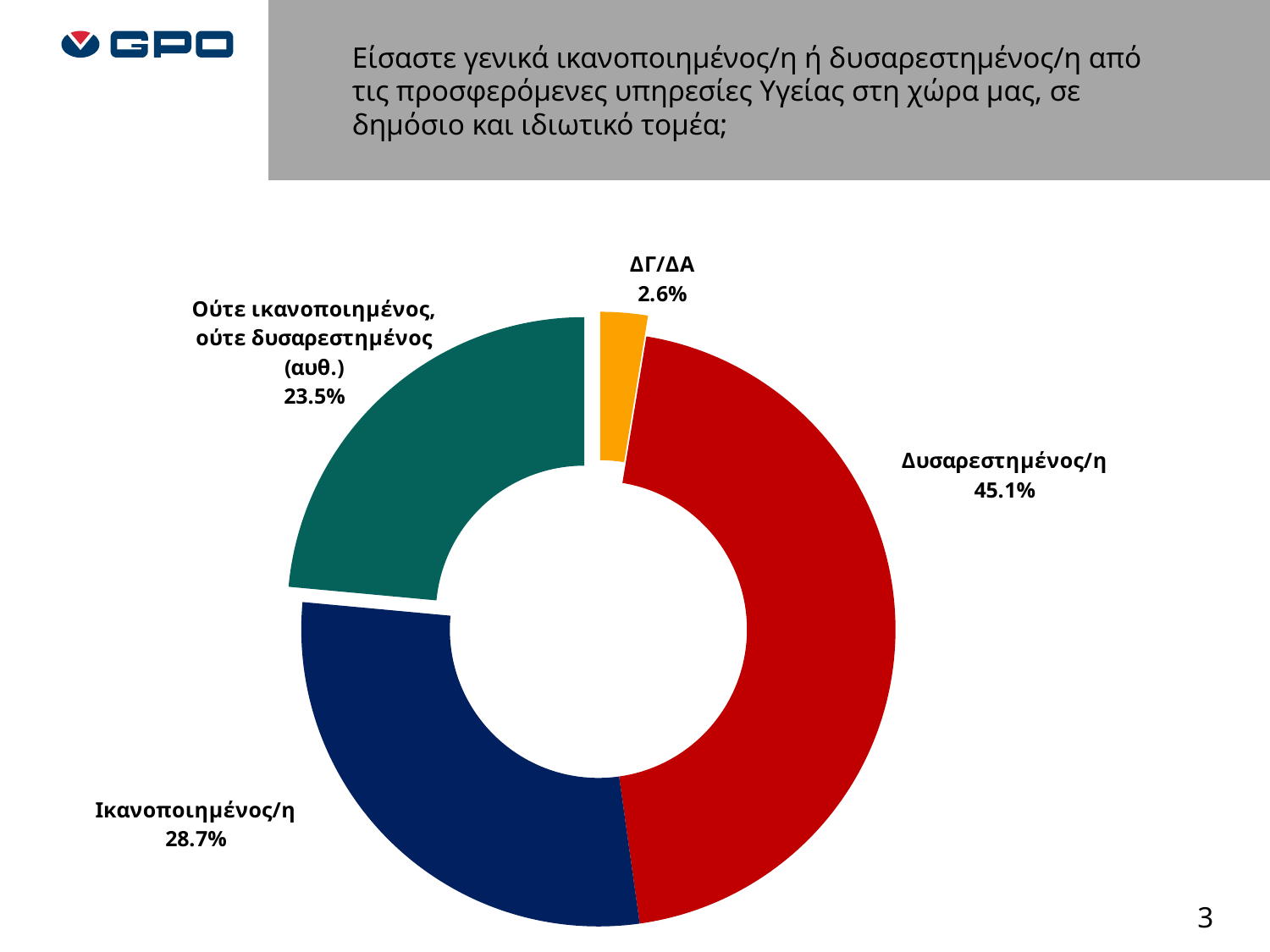
What is the difference in percentage points between Δυσαρεστημένος/η and Ικανοποιημένος/η? 16.4 percentage points Which is larger: the share for Ικανοποιημένος/η or the share for Ούτε ικανοποιημένος, ούτε δυσαρεστημένος (αυθ.)? Ικανοποιημένος/η What percentage of respondents answered Δυσαρεστημένος/η? 45.1% Which category has the largest share of the chart? Δυσαρεστημένος/η Which category has the smallest share of the chart? ΔΓ/ΔΑ What colour is the slice for Δυσαρεστημένος/η? Red What colour is the slice for ΔΓ/ΔΑ? Orange How many categories are shown in the chart? 4 What percentage of respondents answered Ούτε ικανοποιημένος, ούτε δυσαρεστημένος (αυθ.)? 23.5% What percentage of respondents answered Ικανοποιημένος/η? 28.7% What percentage of respondents answered ΔΓ/ΔΑ? 2.6% What kind of chart is shown on the slide? Doughnut (pie) chart